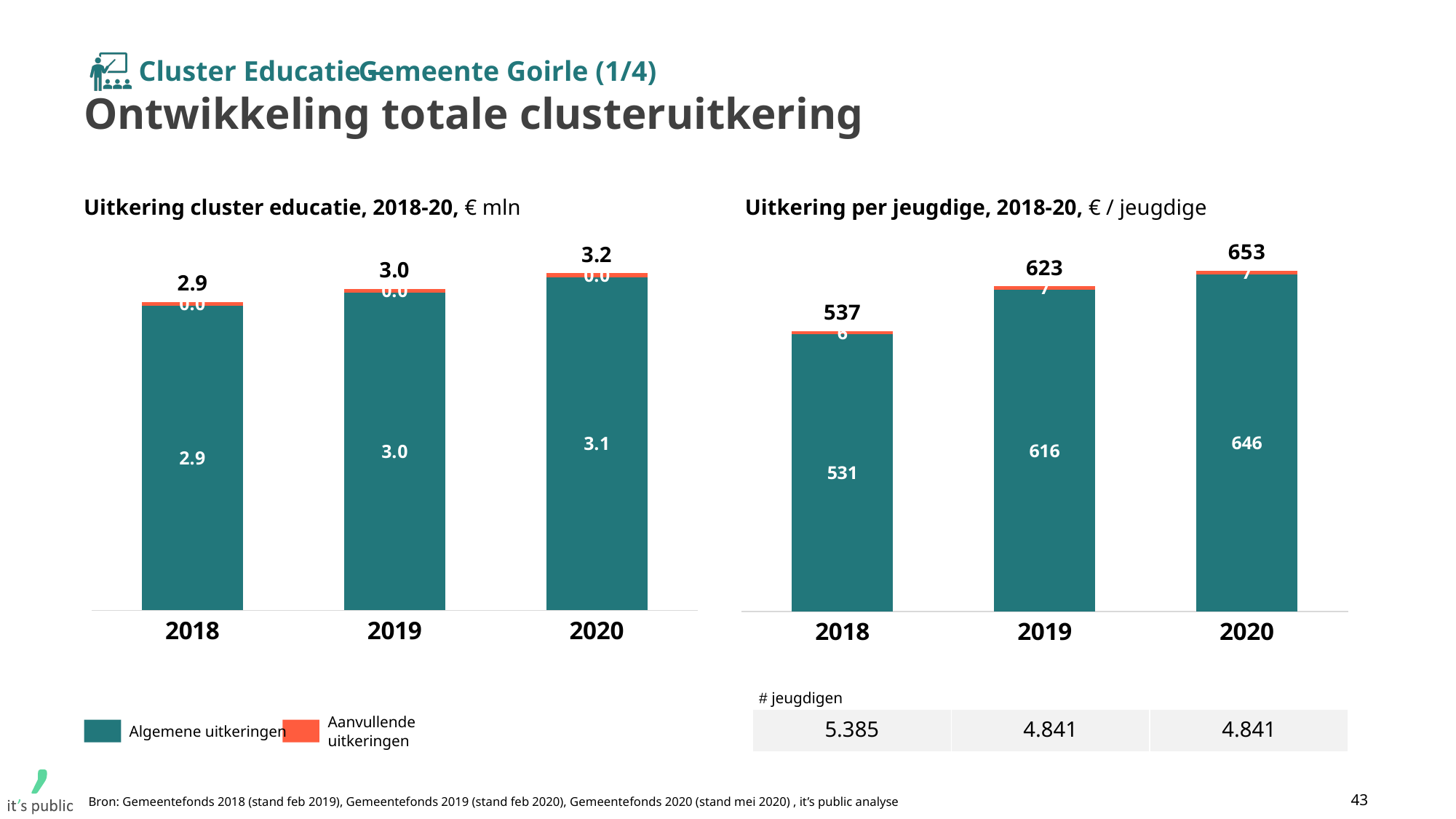
How many series does the legend on the slide list? 2 What kind of chart is 'Uitkering per jeugdige, 2018-20'? Stacked bar chart In the chart 'Uitkering per jeugdige, 2018-20', what is the total value shown above the bar for 2019? 623 In the chart 'Uitkering per jeugdige, 2018-20', is the Algemene uitkeringen value for 2019 larger or smaller than for 2018? larger How many years are shown on the x axis of the chart 'Uitkering cluster educatie, 2018-20'? 3 In the chart 'Uitkering per jeugdige, 2018-20', what is the value of Algemene uitkeringen for 2020? 646 In the chart 'Uitkering per jeugdige, 2018-20', do the totals rise or fall from 2018 to 2020? rise In the chart 'Uitkering per jeugdige, 2018-20', which year has the lowest total? 2018 In the chart 'Uitkering cluster educatie, 2018-20', which year has the highest total? 2020 In the chart 'Uitkering cluster educatie, 2018-20', what is the total value shown above the bar for 2020? 3.2 In the chart 'Uitkering cluster educatie, 2018-20', what is the value of Algemene uitkeringen for 2018? 2.9 In the chart 'Uitkering per jeugdige, 2018-20', what is the difference between the totals for 2020 and 2018? 116